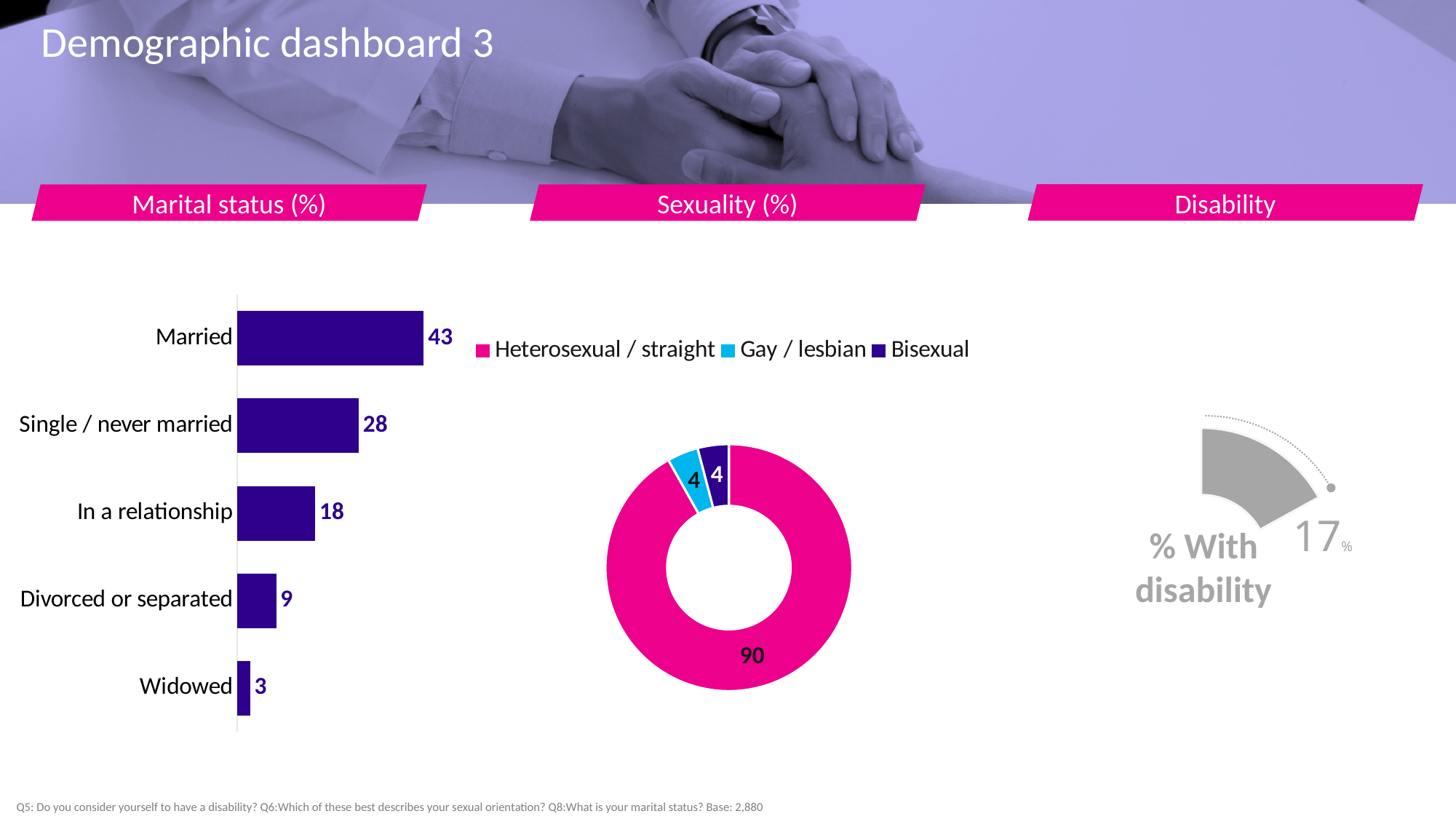
How many categories does the Marital status (%) chart show? 5 In the Sexuality (%) chart, what is the value for Gay / lesbian? 4 In the Marital status (%) chart, what is the value for Divorced or separated? 9 In the Marital status (%) chart, what is the value for Married? 43 How many entries does the legend of the Sexuality (%) chart list? 3 In the Marital status (%) chart, which category has the highest value? Married In the Marital status (%) chart, which is larger: In a relationship or Divorced or separated? In a relationship In the Disability chart, what percentage is shown as having a disability? 17% In the Marital status (%) chart, what is the difference between Married and Single / never married? 15 In the Marital status (%) chart, which category has the lowest value? Widowed What kind of chart is the Marital status (%) chart? Bar chart In the Sexuality (%) chart, what is the value for Heterosexual / straight? 90